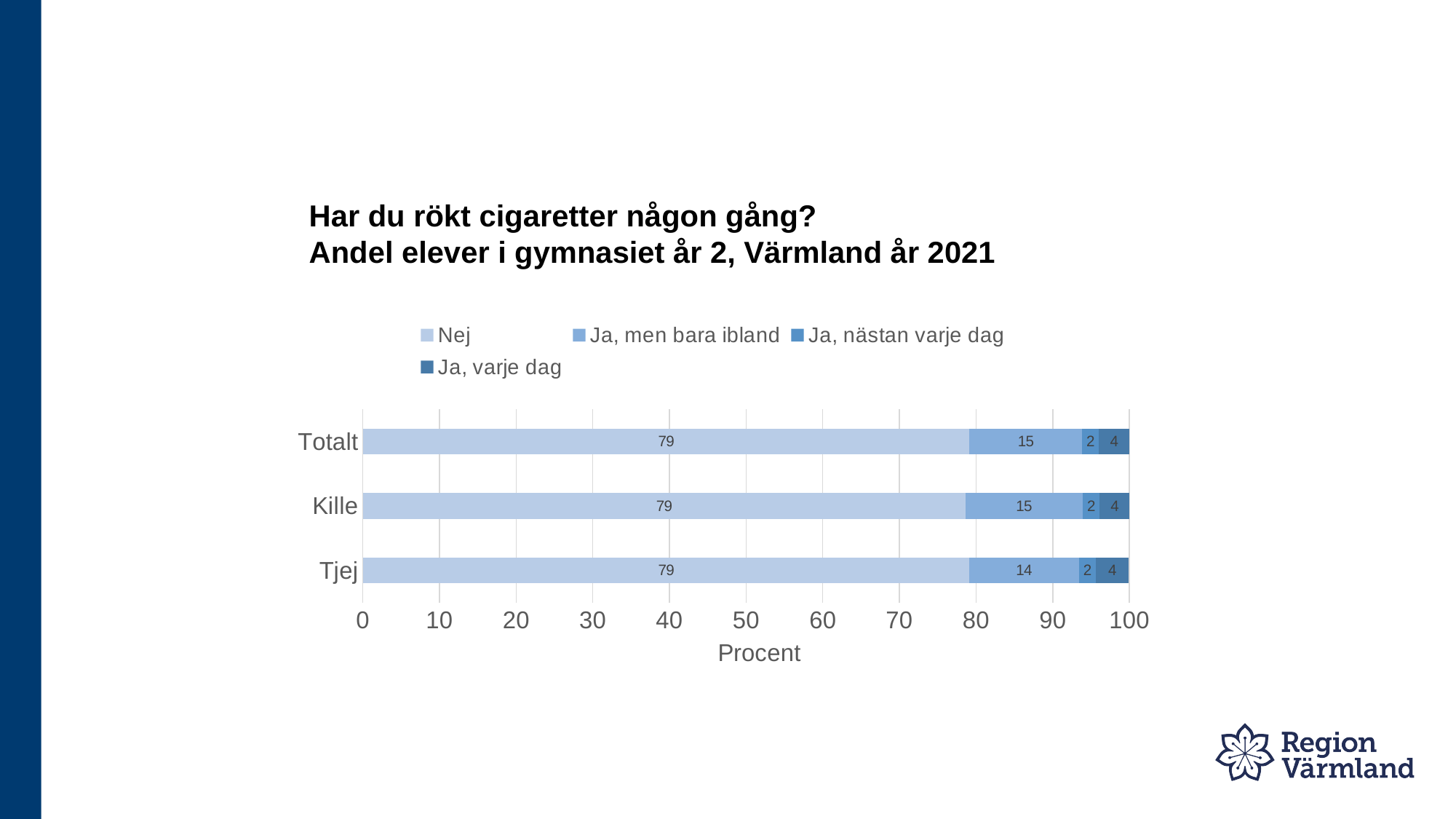
What is the value for "Ja, varje dag" in the Kille bar? 4 Which is larger, the "Ja, varje dag" value for Totalt or the "Ja, nästan varje dag" value for Totalt? Ja, varje dag How many categories are plotted on the y axis? 3 What is the label of the x axis? Procent What is the value for "Nej" in the Totalt bar? 79 What is the total of the Kille stacked bar? 100 What is the difference between the "Ja, men bara ibland" values for Kille and Tjej? 1 What kind of chart is shown on the slide? Stacked bar chart What is the value for "Ja, nästan varje dag" in the Totalt bar? 2 What is the value for "Ja, men bara ibland" in the Tjej bar? 14 What is the total of the Tjej stacked bar? 99 How many series does the legend list? 4